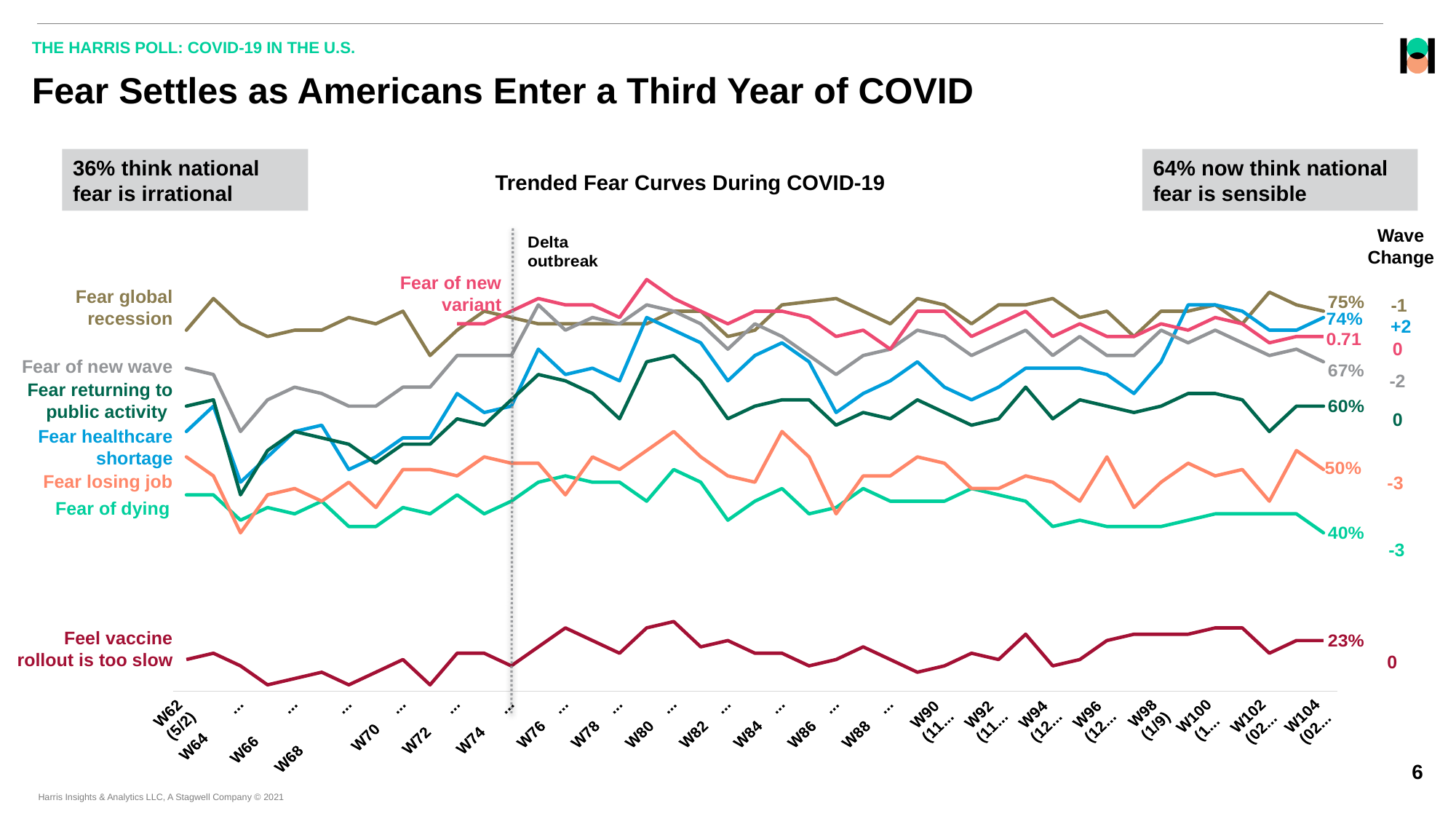
How many fear series are plotted on the chart? 8 What is the latest value shown for Feel vaccine rollout is too slow? 23% What is the title of the chart? Trended Fear Curves During COVID-19 Which series has the highest latest value? Fear global recession What is the latest value shown for Fear of dying? 40% What is the latest value shown for Fear healthcare shortage? 74% What type of chart is shown on the slide? Line chart What is the difference between the latest values for Fear global recession and Fear of dying? 35 percentage points What wave change is shown for Fear healthcare shortage? +2 Which series has the lowest latest value? Feel vaccine rollout is too slow What is the latest value shown for Fear global recession? 75% What wave change is shown for Fear losing job? -3